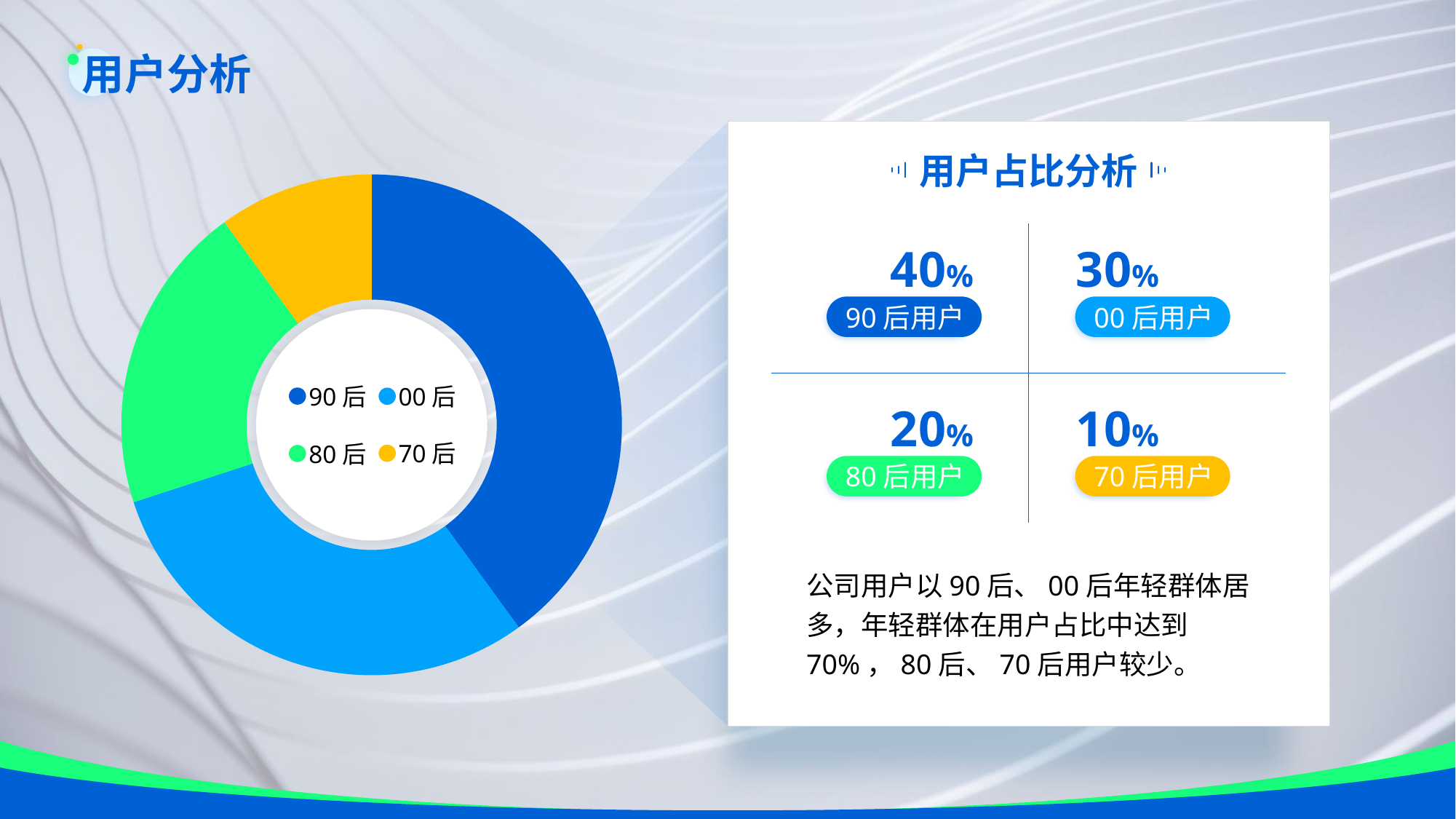
What share of users are 00后 according to the slide? 30% What is the title of the panel to the right of the chart? 用户占比分析 Which is larger, the share of 00后 users or 80后 users? 00后 What colour represents 80后 in the donut chart? Green What share of users are 80后 according to the slide? 20% How many categories does the donut chart show? 4 Which category has the largest slice in the donut chart? 90后 What share of users are 70后 according to the slide? 10% Which category has the smallest slice in the donut chart? 70后 What kind of chart is shown on the slide? Donut (pie) chart What is the difference between the share of 90后 users and 70后 users? 30% What share of users are 90后 according to the slide? 40%